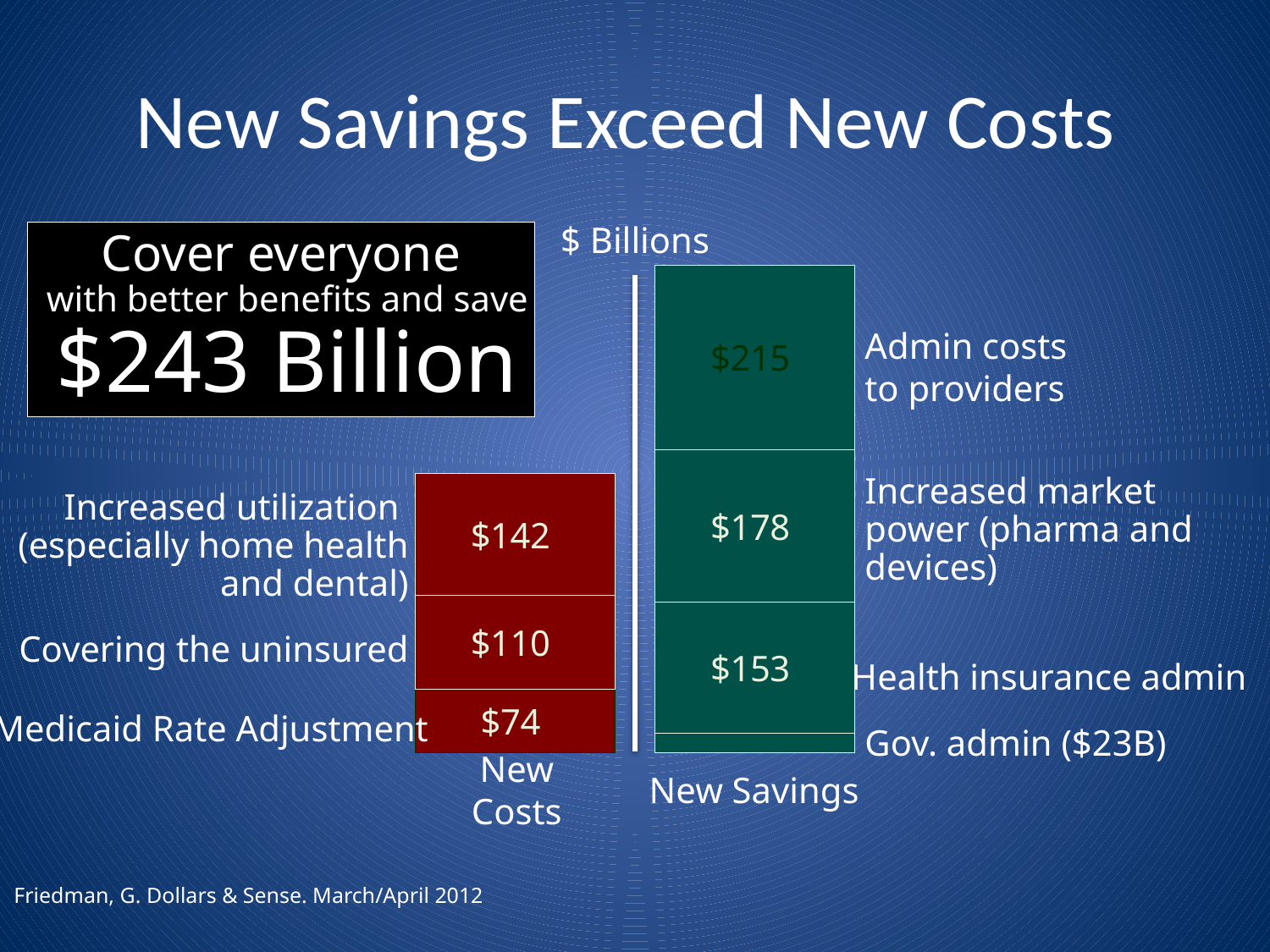
Which segment of the New Costs bar is the smallest? Medicaid Rate Adjustment What is the value of the Health insurance admin segment in the New Savings bar? $153 Which segment of the New Savings bar is the largest? Admin costs to providers What is the value of the Covering the uninsured segment in the New Costs bar? $110 What is the difference between the Increased utilization segment ($142) and the Covering the uninsured segment ($110) in the New Costs bar? $32 What is the value of the Admin costs to providers segment in the New Savings bar? $215 What is the value of the Medicaid Rate Adjustment segment in the New Costs bar? $74 What is the total of the New Costs bar? $326 What unit is shown for the values in the chart? $ Billions What is the value of the Increased utilization segment in the New Costs bar? $142 What is the value of the Gov. admin segment in the New Savings bar? $23B What kind of chart is shown on the slide? Stacked bar chart